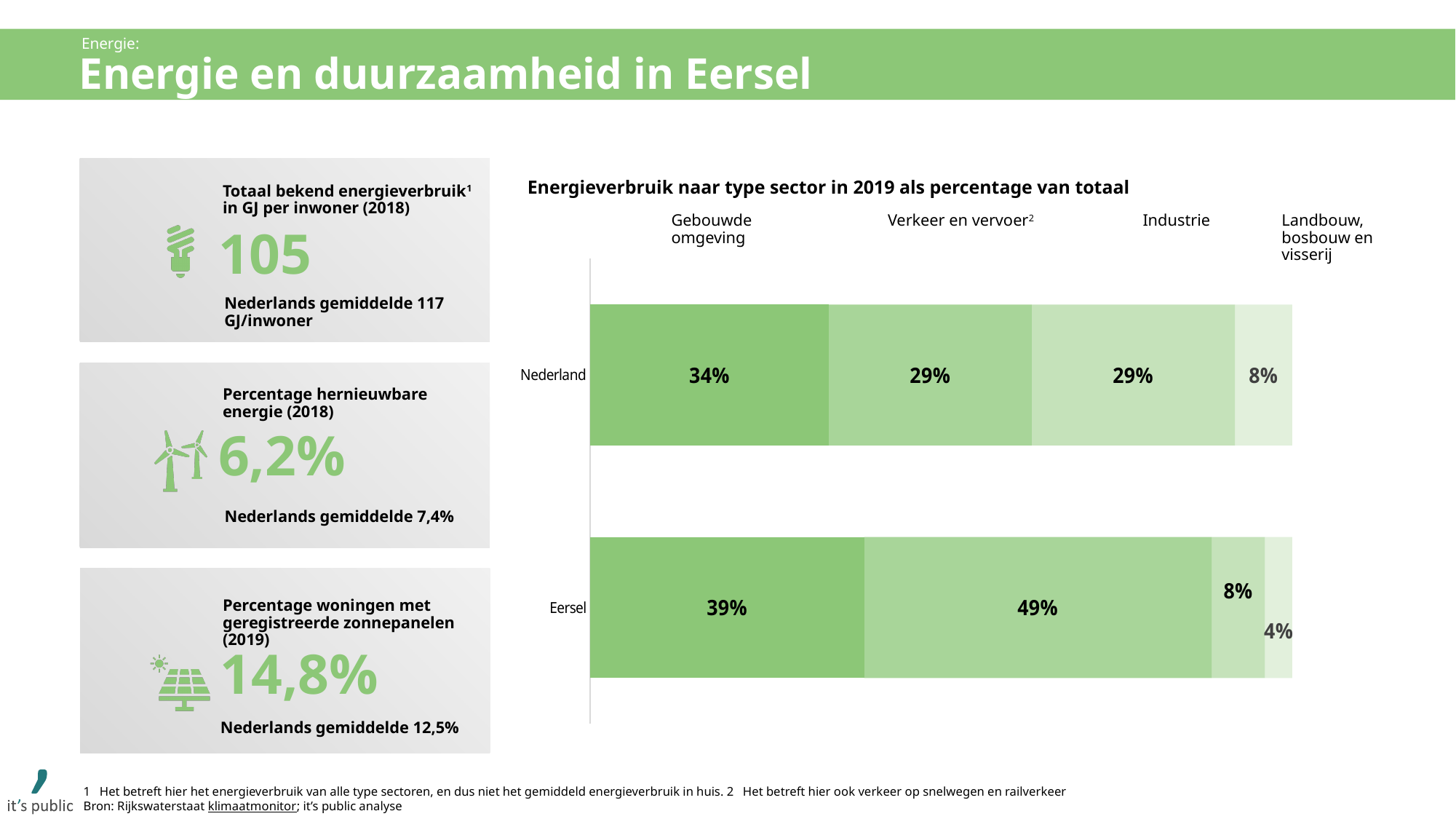
What is the value for Landbouw, bosbouw en visserij for Nederland? 8% What is the value for Gebouwde omgeving for Nederland? 34% What is the value for Verkeer en vervoer for Eersel? 49% Which is larger: the Industrie share for Nederland or for Eersel? Nederland How many bars (regions) are shown in the chart? 2 Which sector has the largest share for Eersel? Verkeer en vervoer What is the title of the chart? Energieverbruik naar type sector in 2019 als percentage van totaal What is the difference between the Verkeer en vervoer share for Eersel and for Nederland? 20 percentage points What is the value for Industrie for Eersel? 8% Which sector has the smallest share for Eersel? Landbouw, bosbouw en visserij How many sectors are shown in the chart? 4 What kind of chart is shown on the slide? Stacked bar chart